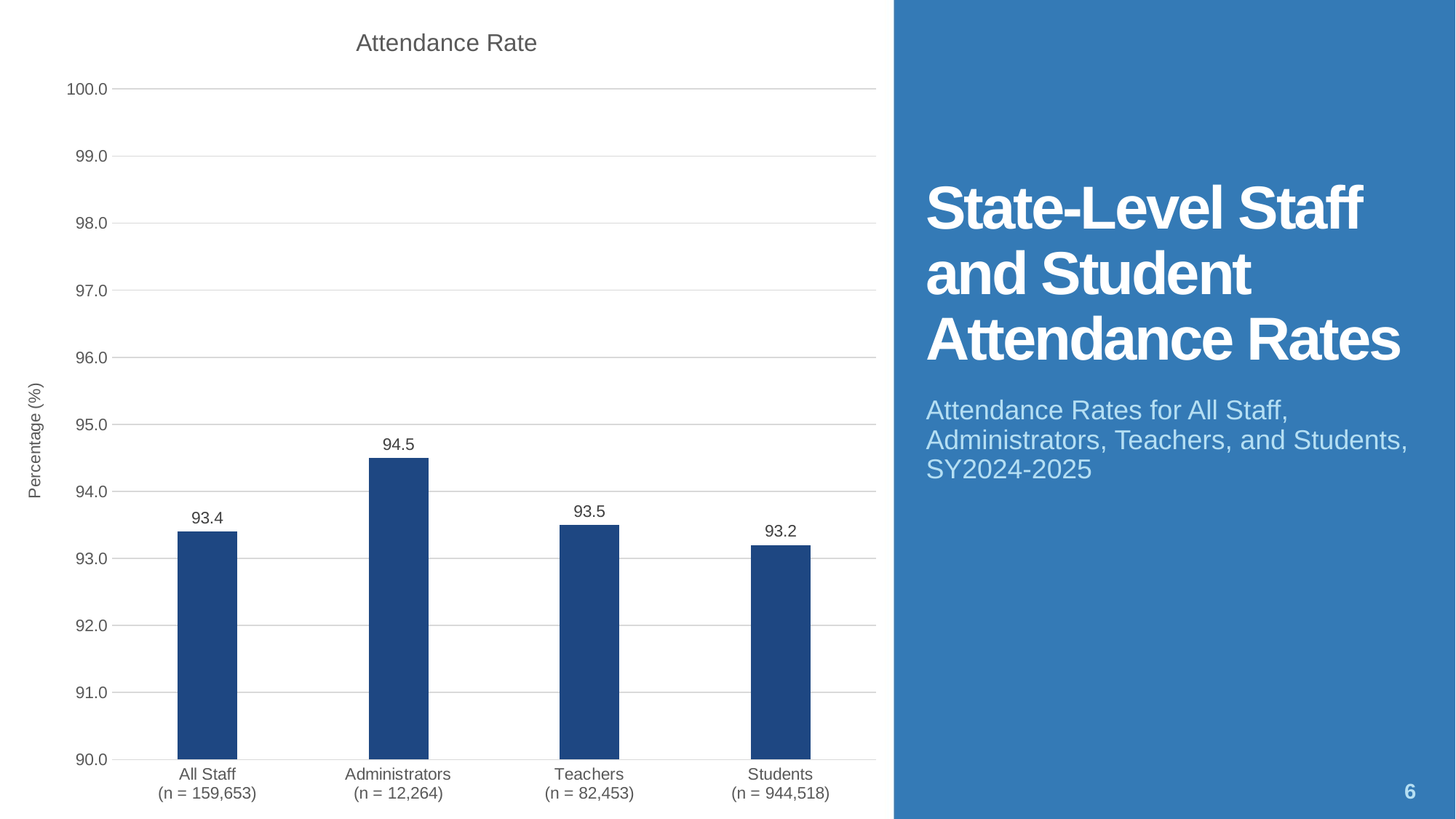
Is the value for Administrators greater or less than 94.0? greater Which category has the highest attendance rate? Administrators How many categories are shown in the chart? 4 What is the attendance rate for All Staff? 93.4 What is the attendance rate for Administrators? 94.5 What is the attendance rate for Students? 93.2 What kind of chart is shown on the slide? Bar chart What is the difference between the attendance rates for Administrators and Students? 1.3 What is the attendance rate for Teachers? 93.5 What is the title of the chart? Attendance Rate Which has a higher attendance rate, Administrators or Teachers? Administrators Which category has the lowest attendance rate? Students